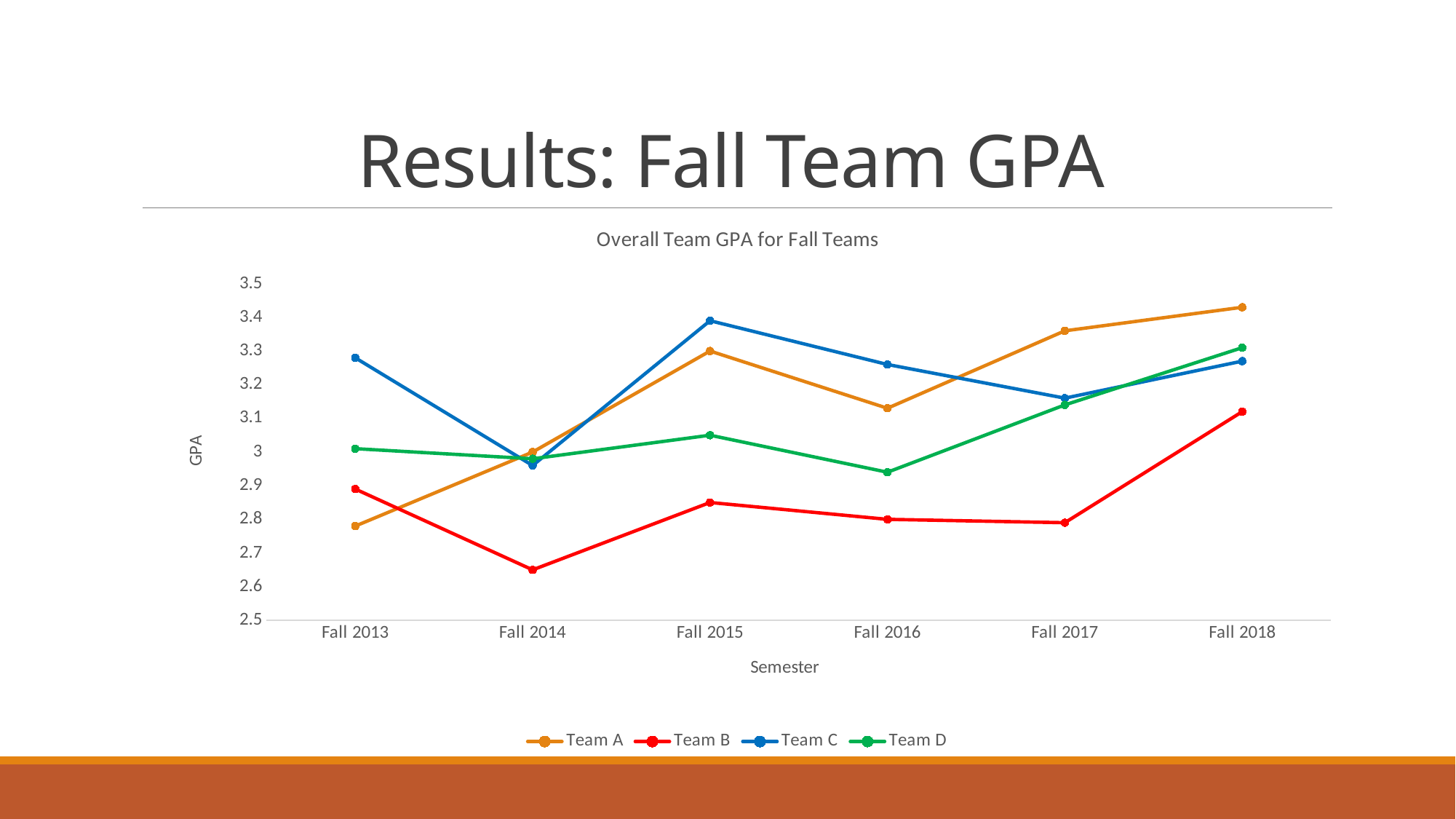
How many semesters are plotted along the x axis? 6 How many series does the legend list? 4 In Fall 2016, which is higher: Team A or Team D? Team A Is the value for Team B in Fall 2014 greater or less than 2.7? less Is the value for Team C in Fall 2015 greater or less than 3.3? greater In which semester does Team B reach its lowest GPA? Fall 2014 What is the title of the x axis? Semester Which team has the highest GPA in Fall 2018? Team A What kind of chart is shown on the slide? line chart Which team has the lowest GPA in Fall 2014? Team B Which team has the highest GPA in Fall 2013? Team C Does Team A's GPA rise or fall from Fall 2016 to Fall 2018? rise